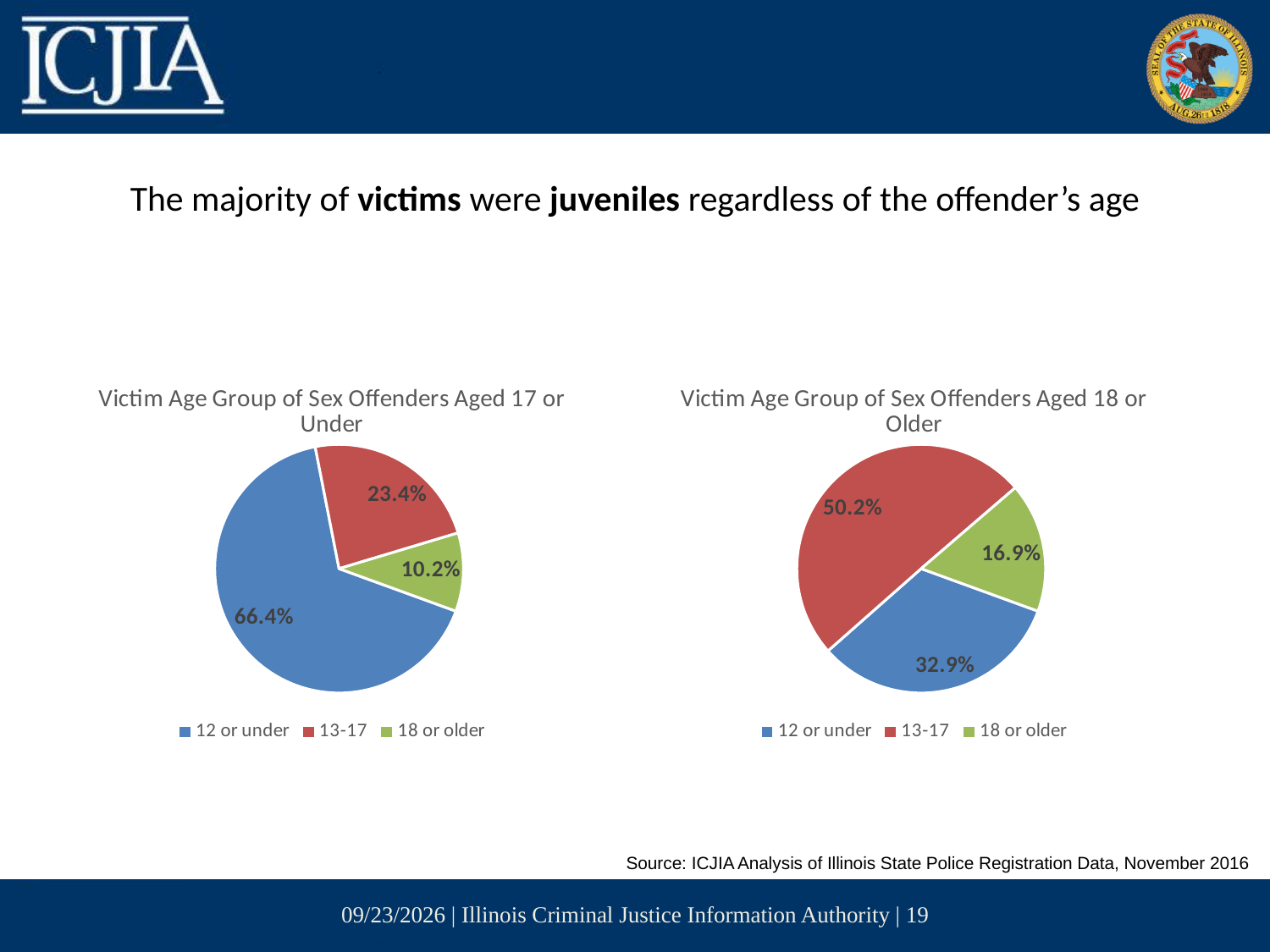
How many victim age groups does the legend of each chart list? 3 In the 'Victim Age Group of Sex Offenders Aged 18 or Older' chart, what is the difference in percentage points between the 13-17 and 12 or under slices? 17.3 In the 'Victim Age Group of Sex Offenders Aged 17 or Under' chart, what is the difference in percentage points between the 12 or under and 13-17 slices? 43.0 In the 'Victim Age Group of Sex Offenders Aged 18 or Older' chart, what percentage of victims were 12 or under? 32.9% In the 'Victim Age Group of Sex Offenders Aged 18 or Older' chart, which victim age group has the largest share? 13-17 Which chart has a larger share of victims aged 18 or older: the one for offenders aged 17 or under, or the one for offenders aged 18 or older? Offenders aged 18 or older In the 'Victim Age Group of Sex Offenders Aged 18 or Older' chart, which victim age group has the smallest share? 18 or older In the 'Victim Age Group of Sex Offenders Aged 17 or Under' chart, what percentage of victims were 13-17? 23.4% In the 'Victim Age Group of Sex Offenders Aged 17 or Under' chart, what percentage of victims were 12 or under? 66.4% In the 'Victim Age Group of Sex Offenders Aged 17 or Under' chart, which victim age group has the largest share? 12 or under What type of chart is used on this slide? Pie chart In the 'Victim Age Group of Sex Offenders Aged 18 or Older' chart, what percentage of victims were 18 or older? 16.9%